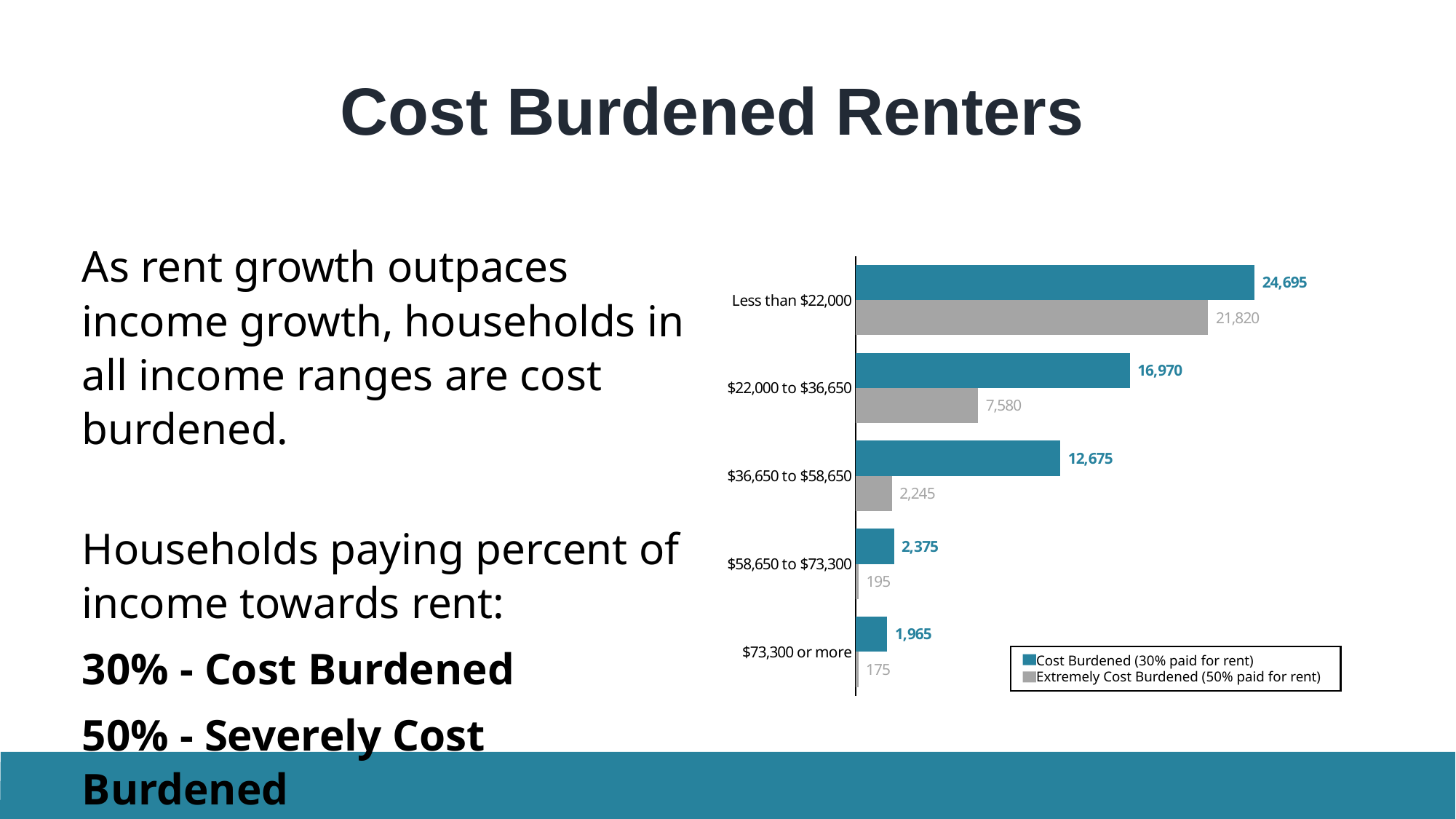
What is the Extremely Cost Burdened value for the $73,300 or more income range? 175 What is the difference between the Cost Burdened and Extremely Cost Burdened values for the $36,650 to $58,650 income range? 10,430 What kind of chart is shown on the slide? Bar chart What is the Cost Burdened (30% paid for rent) value for the Less than $22,000 income range? 24,695 What is the difference between the Cost Burdened values for Less than $22,000 and $22,000 to $36,650? 7,725 Which is larger: the Extremely Cost Burdened value for $22,000 to $36,650 or the Cost Burdened value for $58,650 to $73,300? Extremely Cost Burdened value for $22,000 to $36,650 Which income range has the lowest Extremely Cost Burdened (50% paid for rent) value? $73,300 or more Which colour represents the Extremely Cost Burdened (50% paid for rent) series? Gray Which income range has the highest Cost Burdened (30% paid for rent) value? Less than $22,000 How many series does the legend list? 2 What is the Extremely Cost Burdened (50% paid for rent) value for the $22,000 to $36,650 income range? 7,580 How many income ranges are shown on the chart? 5